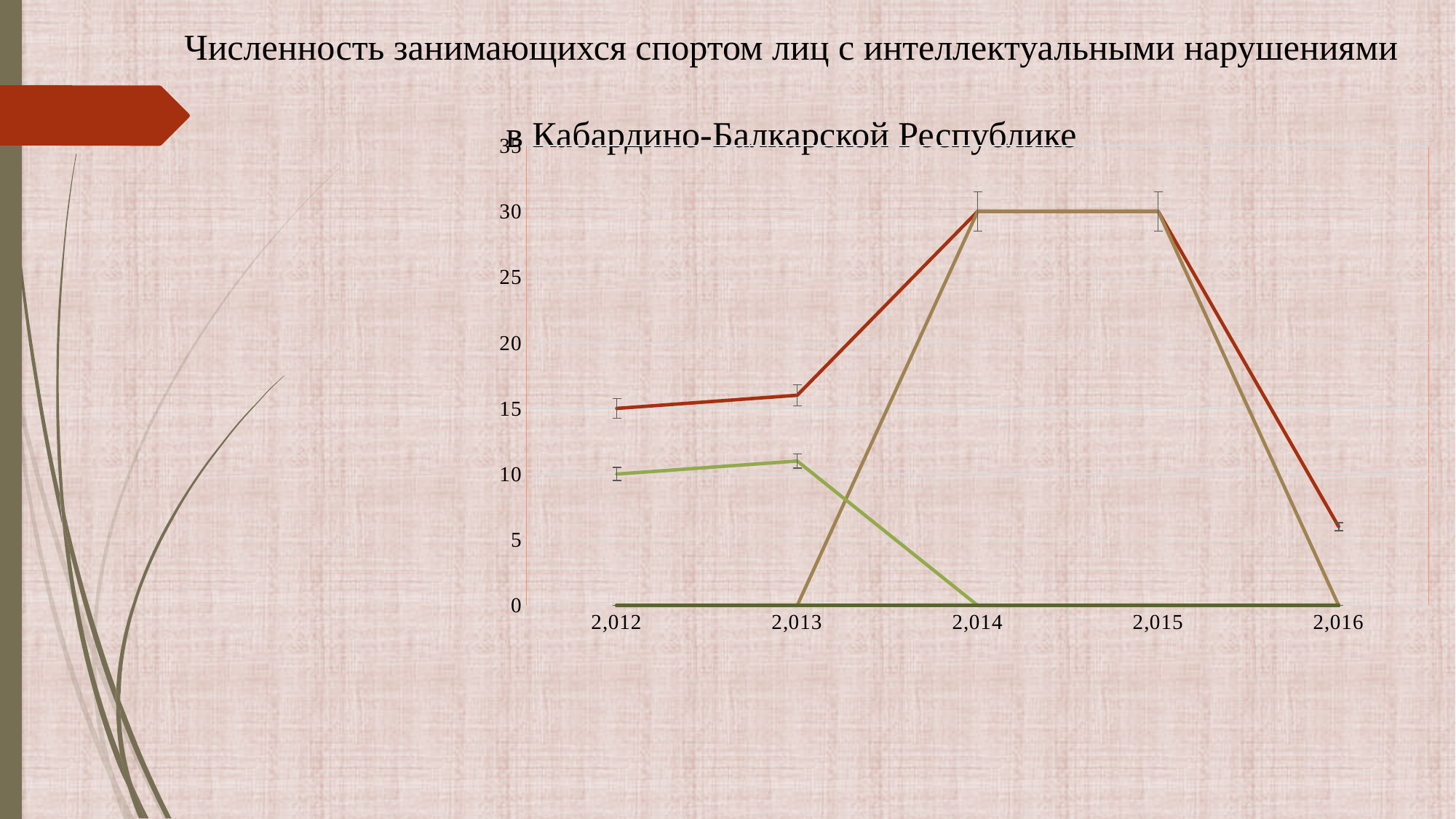
Is the value of the red line at 2,016 greater or less than 10? less What kind of chart is shown on the slide? line chart What is the first line of the chart's title? Численность занимающихся спортом лиц с интеллектуальными нарушениями What is the value of the light green line at 2,012? 10 What is the value of the red line at 2,012? 15 How many years are shown along the x axis of the chart? 5 Does the tan line rise or fall between 2,015 and 2,016? fall What is the value of the tan line at 2,016? 0 At 2,012, which line is higher, the red line or the light green line? the red line What is the value of the red line at 2,014? 30 What is the value of the light green line at 2,014? 0 Is the value of the red line at 2,013 greater or less than 20? less